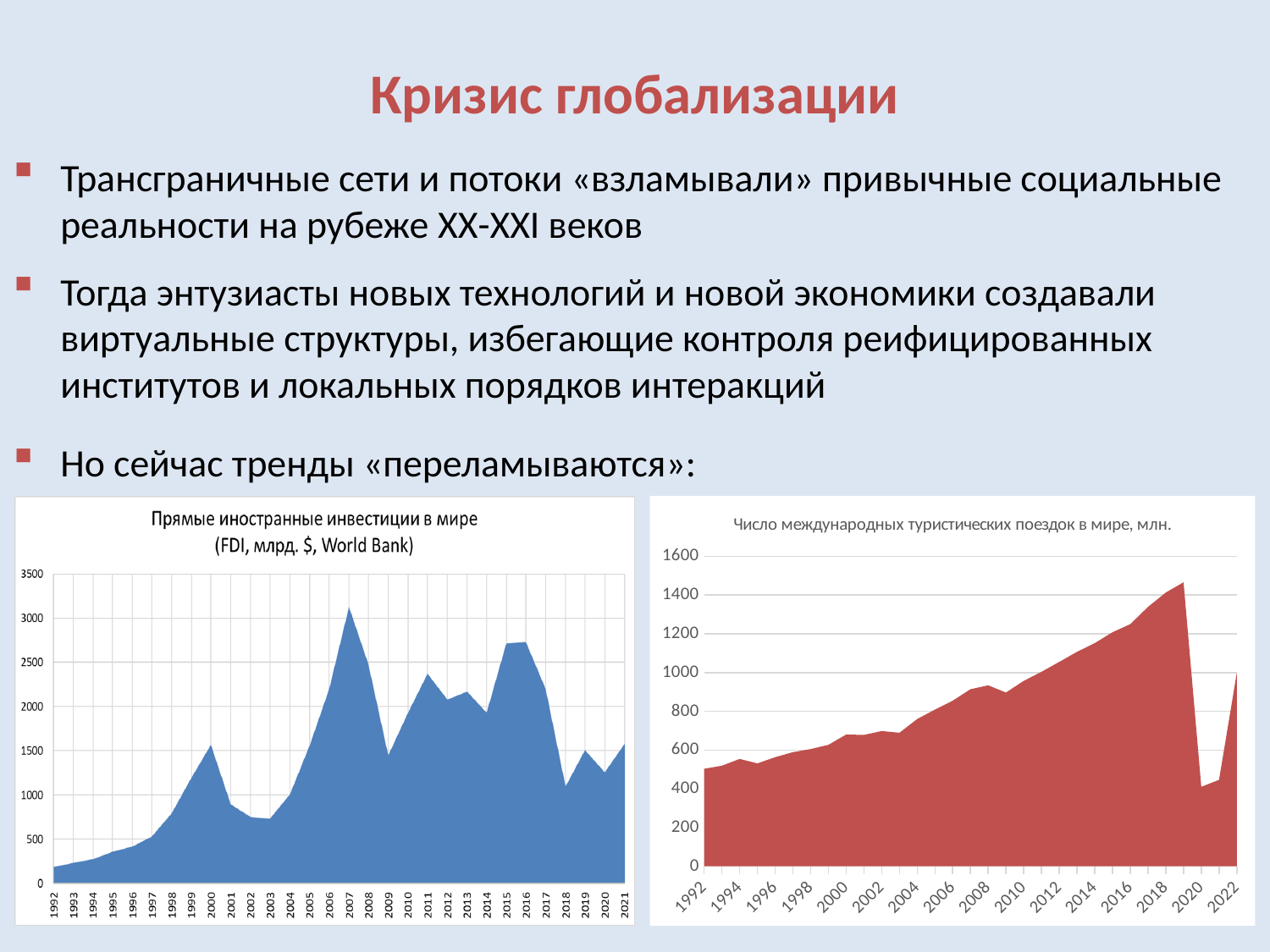
In the right chart 'Число международных туристических поездок в мире, млн.', which year has the lowest value? 2020 In the right chart 'Число международных туристических поездок в мире, млн.', which year has the highest value? 2019 What kind of chart is the right chart, 'Число международных туристических поездок в мире, млн.'? Area chart In the right chart 'Число международных туристических поездок в мире, млн.', is the value for 2020 greater or less than 600? less What kind of chart is the left chart, 'Прямые иностранные инвестиции в мире'? Area chart In the left chart 'Прямые иностранные инвестиции в мире', which is larger, the value for 2007 or the value for 2016? 2007 In the left chart 'Прямые иностранные инвестиции в мире', is the value for 2007 greater or less than 2500? greater In the left chart 'Прямые иностранные инвестиции в мире', is the value for 2003 greater or less than 1000? less What colour is the filled area in the right chart 'Число международных туристических поездок в мире, млн.'? Red In the left chart 'Прямые иностранные инвестиции в мире', which year has the lowest value? 1992 In the right chart 'Число международных туристических поездок в мире, млн.', do the values rise or fall from 1992 to 2019? rise In the left chart 'Прямые иностранные инвестиции в мире', which year has the highest value? 2007